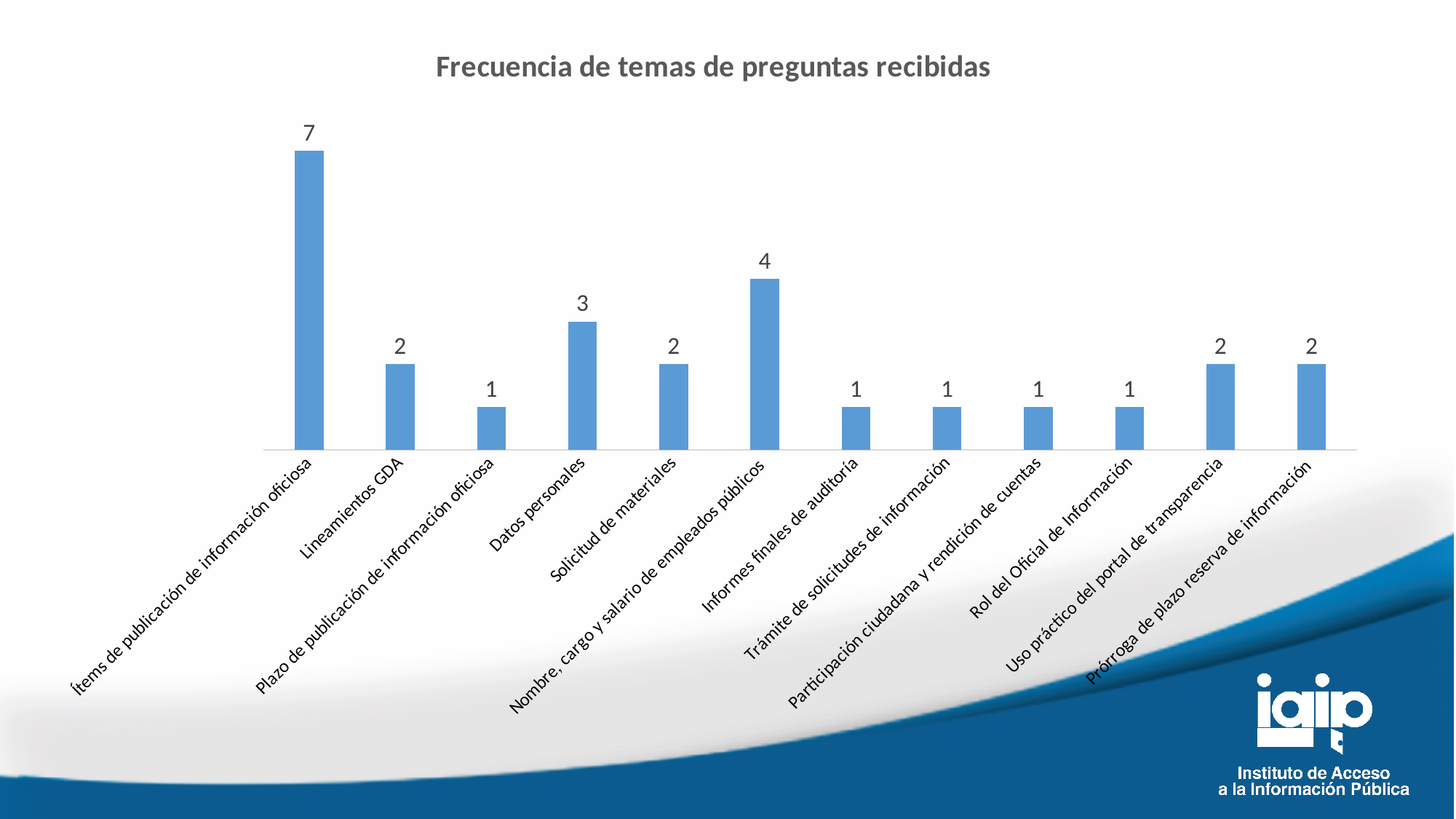
How many categories have a value of 1? 5 What is the difference between the values for "Ítems de publicación de información oficiosa" and "Nombre, cargo y salario de empleados públicos"? 3 What is the value for "Prórroga de plazo reserva de información"? 2 How many categories are shown on the x axis? 12 Which is larger, the value for "Datos personales" or the value for "Lineamientos GDA"? Datos personales What is the value for "Ítems de publicación de información oficiosa"? 7 What is the value for "Nombre, cargo y salario de empleados públicos"? 4 What is the value for "Rol del Oficial de Información"? 1 Which category has the highest value? Ítems de publicación de información oficiosa What is the value for "Datos personales"? 3 What kind of chart is shown on the slide? Bar chart What is the title of the chart? Frecuencia de temas de preguntas recibidas